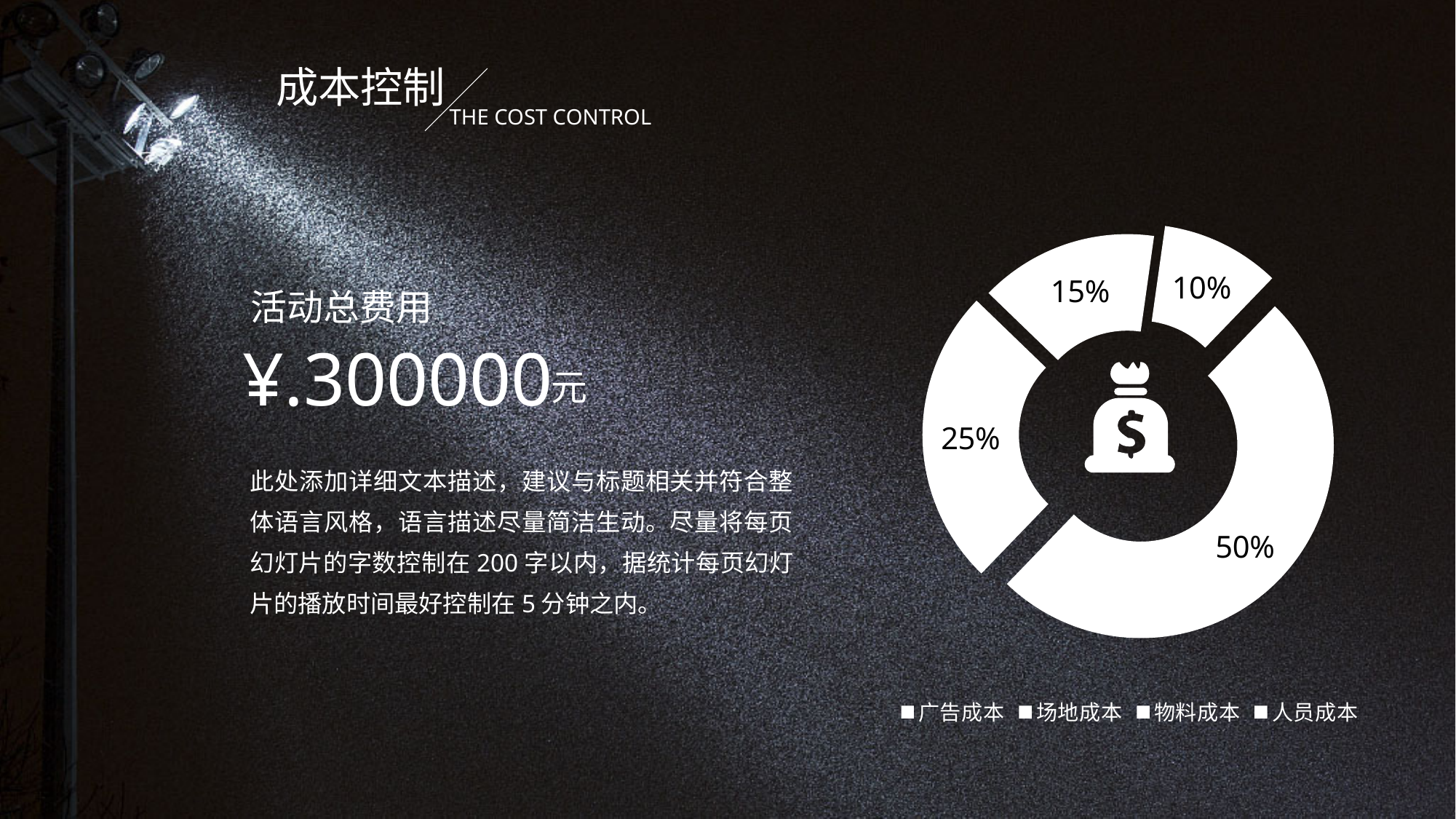
What do the four slices of the doughnut chart add up to? 100% How many entries does the legend of the doughnut chart list? 4 What is the largest percentage shown on the doughnut chart? 50% What are the four legend entries listed below the doughnut chart? 广告成本, 场地成本, 物料成本, 人员成本 Which slice of the doughnut chart is larger, the 25% slice or the 15% slice? The 25% slice What is the difference in percentage points between the largest slice (50%) and the smallest slice (10%) of the doughnut chart? 40 percentage points What is the smallest percentage shown on the doughnut chart? 10% How many slices does the doughnut chart have? 4 What total amount is stated on the slide under 活动总费用? ¥.300000元 What is the difference in percentage points between the 25% slice and the 15% slice of the doughnut chart? 10 percentage points What kind of chart is shown on the slide? Doughnut chart